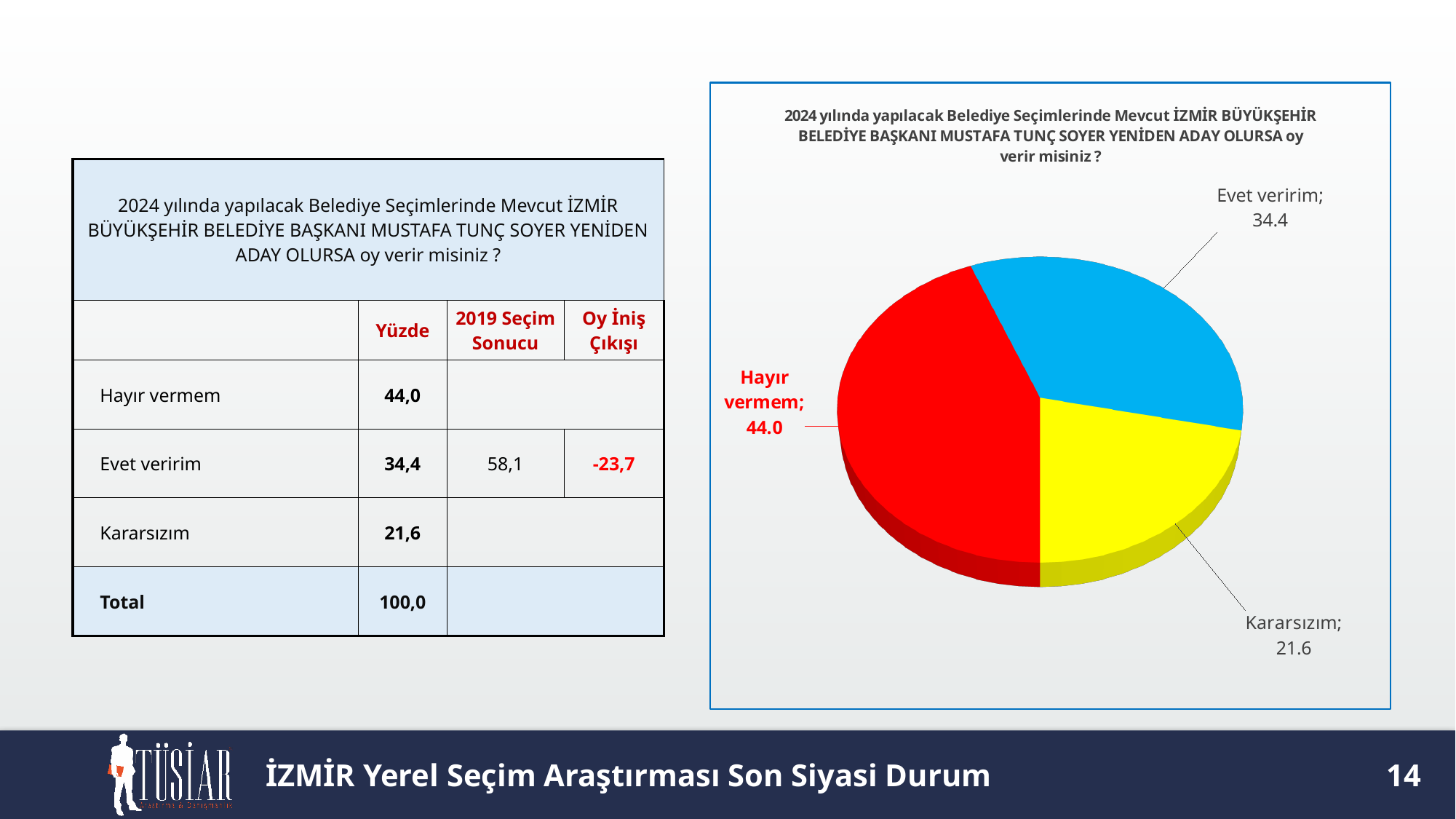
What colour is the Kararsızım slice in the pie chart? Yellow How many slices does the pie chart have? 3 What is the value for Hayır vermem in the pie chart? 44.0 Which category has the largest slice in the pie chart? Hayır vermem What is the difference between the values for Hayır vermem and Evet veririm in the pie chart? 9.6 What is the value for Kararsızım in the pie chart? 21.6 What kind of chart is shown on the slide? Pie chart What is the difference between the values for Evet veririm and Kararsızım in the pie chart? 12.8 What is the value for Evet veririm in the pie chart? 34.4 What colour is the Hayır vermem slice in the pie chart? Red Which is larger in the pie chart, Evet veririm or Kararsızım? Evet veririm Which category has the smallest slice in the pie chart? Kararsızım